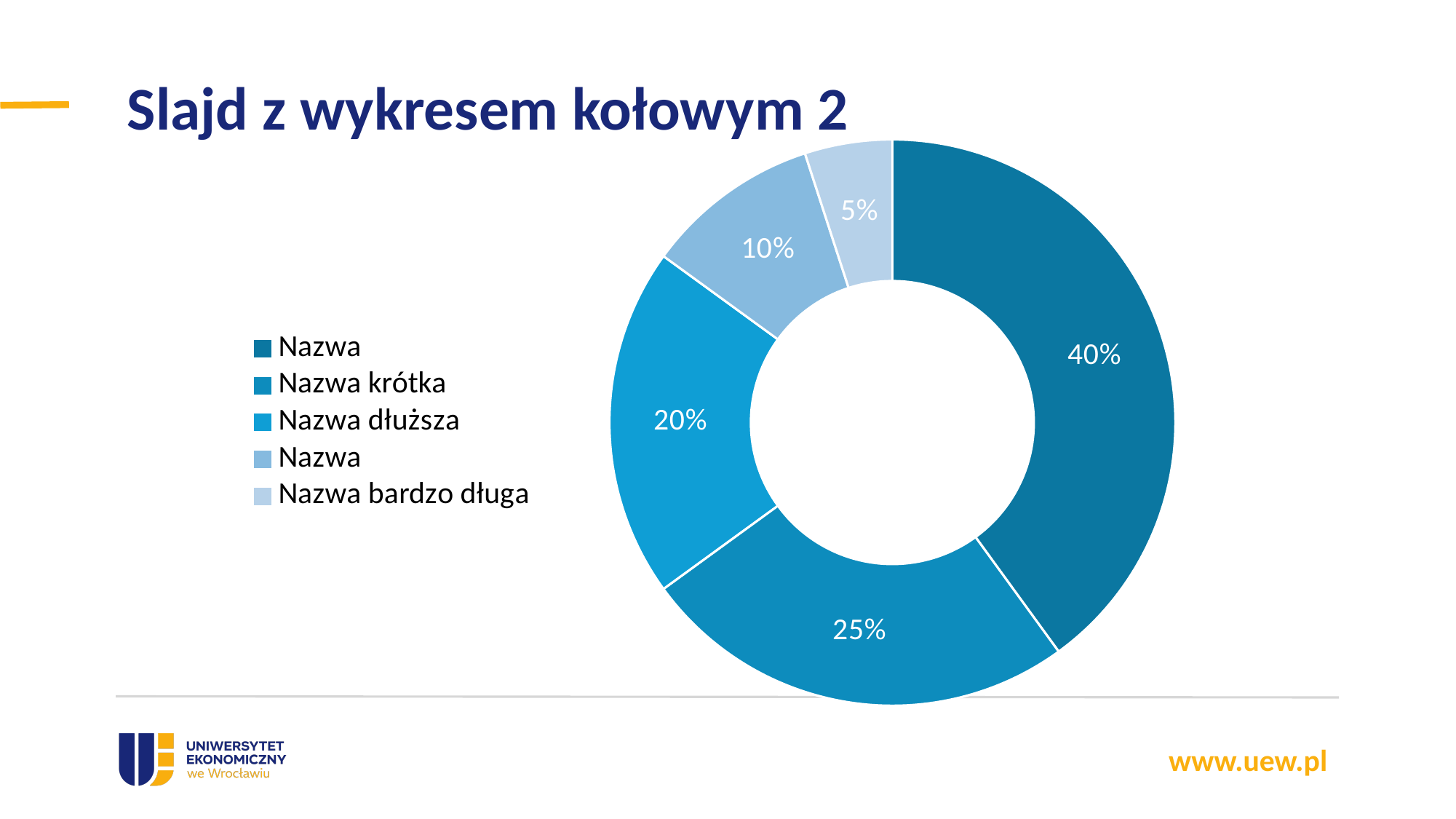
How many entries does the legend list? 5 What percentage is shown for Nazwa bardzo długa? 5% Which is larger, the Nazwa krótka slice or the Nazwa bardzo długa slice? Nazwa krótka What percentage is shown for Nazwa krótka? 25% What is the title of the slide with the chart? Slajd z wykresem kołowym 2 What is the difference between the Nazwa krótka slice and the Nazwa dłuższa slice? 5% What kind of chart is shown on the slide? doughnut chart What is the largest percentage shown on the chart? 40% Which legend entry has the smallest slice? Nazwa bardzo długa What percentage is shown for Nazwa dłuższa? 20% What is the combined share of the Nazwa krótka and Nazwa dłuższa slices? 45% How many slices does the chart have? 5